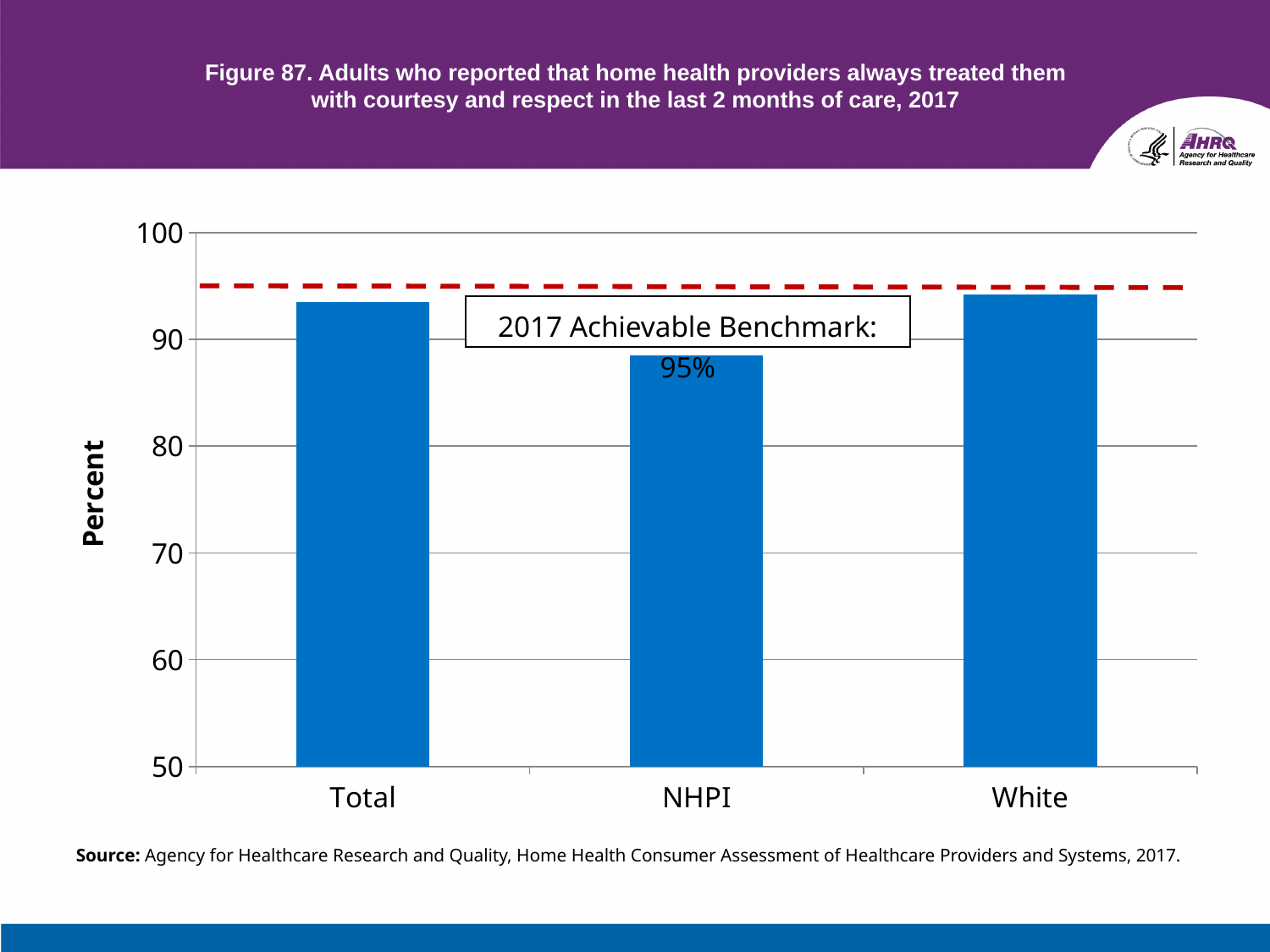
Is the value for NHPI greater or less than 90? less Which is larger, the value for Total or the value for NHPI? Total Is the value for NHPI greater or less than 80? greater How many categories are plotted on the x axis? 3 What is the 2017 Achievable Benchmark shown by the dashed line? 95% What is the label of the y axis? Percent Is the value for White greater or less than 90? greater Which category has the lowest value? NHPI Which is larger, the value for White or the value for NHPI? White What kind of chart is shown on the slide? bar chart